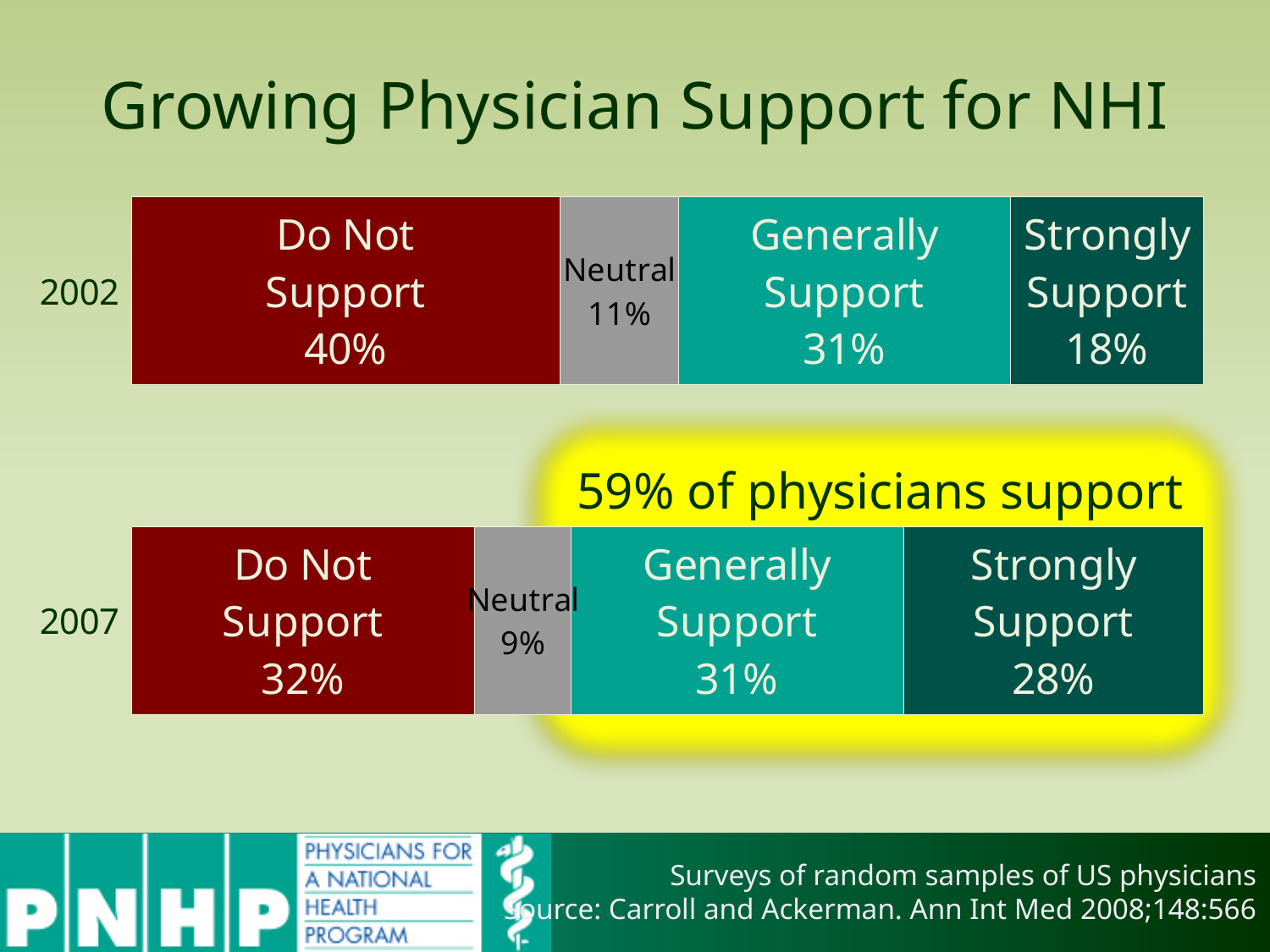
What is the combined share of Generally Support and Strongly Support in 2007? 59% What was the Neutral share in 2007? 9% How many response categories are shown in each bar? 4 What percentage of physicians did not support NHI in 2002? 40% In 2007, which was larger: Generally Support or Strongly Support? Generally Support By how many percentage points did Strongly Support increase from 2002 to 2007? 10 percentage points Which response category had the largest share in 2002? Do Not Support What was the Generally Support share in 2002? 31% By how many percentage points did Do Not Support fall from 2002 to 2007? 8 percentage points What type of chart is shown on the slide? Stacked bar chart Which response category had the smallest share in 2007? Neutral What percentage of physicians strongly supported NHI in 2007? 28%